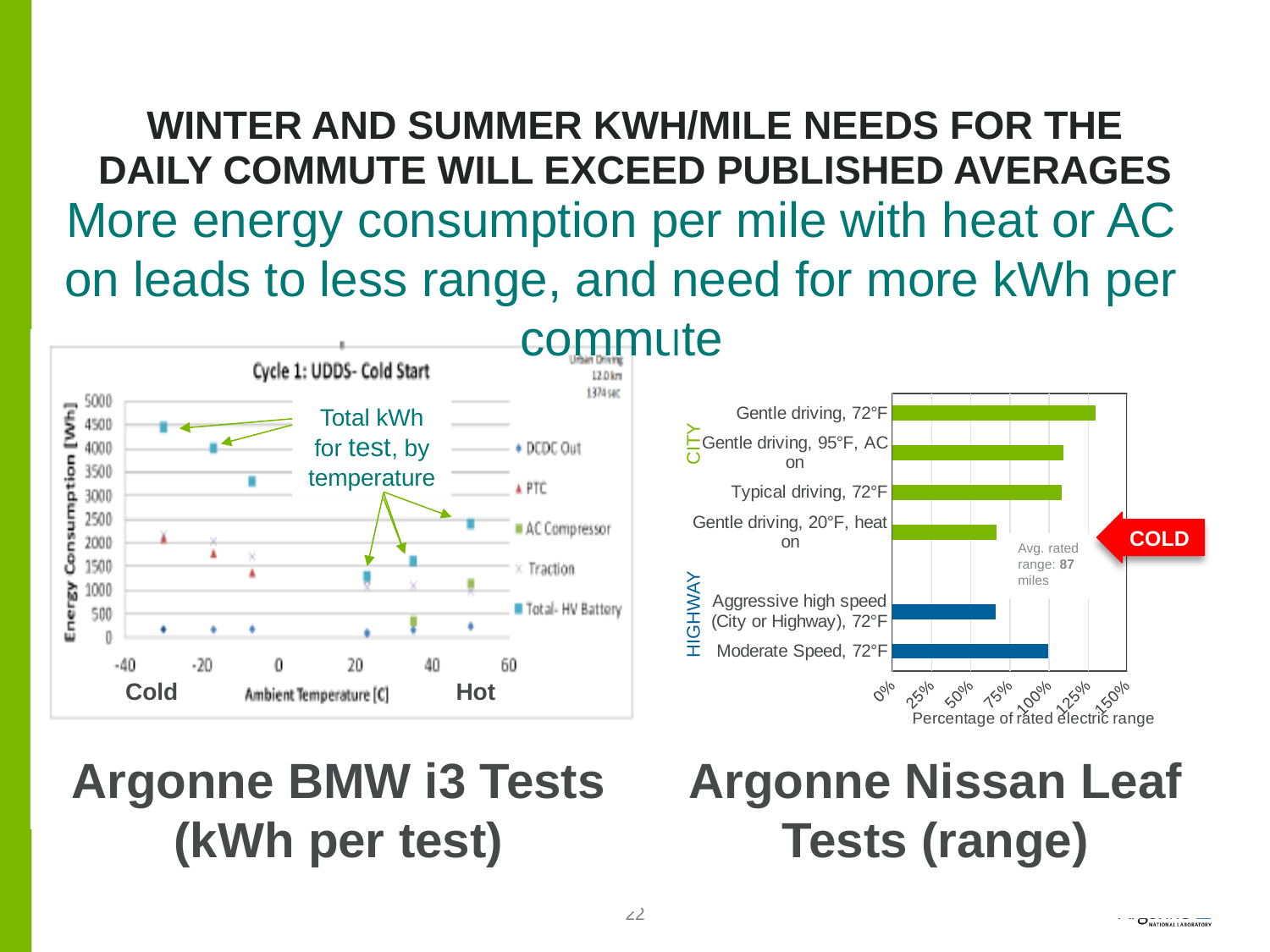
On the right chart (Argonne Nissan Leaf Tests), what is the label of the horizontal axis? Percentage of rated electric range What kind of chart is the right chart (Argonne Nissan Leaf Tests)? bar chart On the right chart (Argonne Nissan Leaf Tests), is the value for Gentle driving, 20°F, heat on greater or less than 75%? less On the right chart (Argonne Nissan Leaf Tests), is the value for Aggressive high speed (City or Highway), 72°F greater or less than 75%? less On the left chart (Argonne BMW i3 Tests), how many series does the legend list? 5 On the right chart (Argonne Nissan Leaf Tests), which is larger: Gentle driving, 72°F or Gentle driving, 20°F, heat on? Gentle driving, 72°F On the right chart (Argonne Nissan Leaf Tests), which is larger: Moderate Speed, 72°F or Aggressive high speed (City or Highway), 72°F? Moderate Speed, 72°F On the left chart (Argonne BMW i3 Tests), is the Total- HV Battery value at -30 °C greater or less than 4000 Wh? greater On the right chart (Argonne Nissan Leaf Tests), which category has the highest percentage of rated electric range? Gentle driving, 72°F On the right chart (Argonne Nissan Leaf Tests), how many categories are plotted? 6 What is the title of the left chart (Argonne BMW i3 Tests)? Cycle 1: UDDS- Cold Start